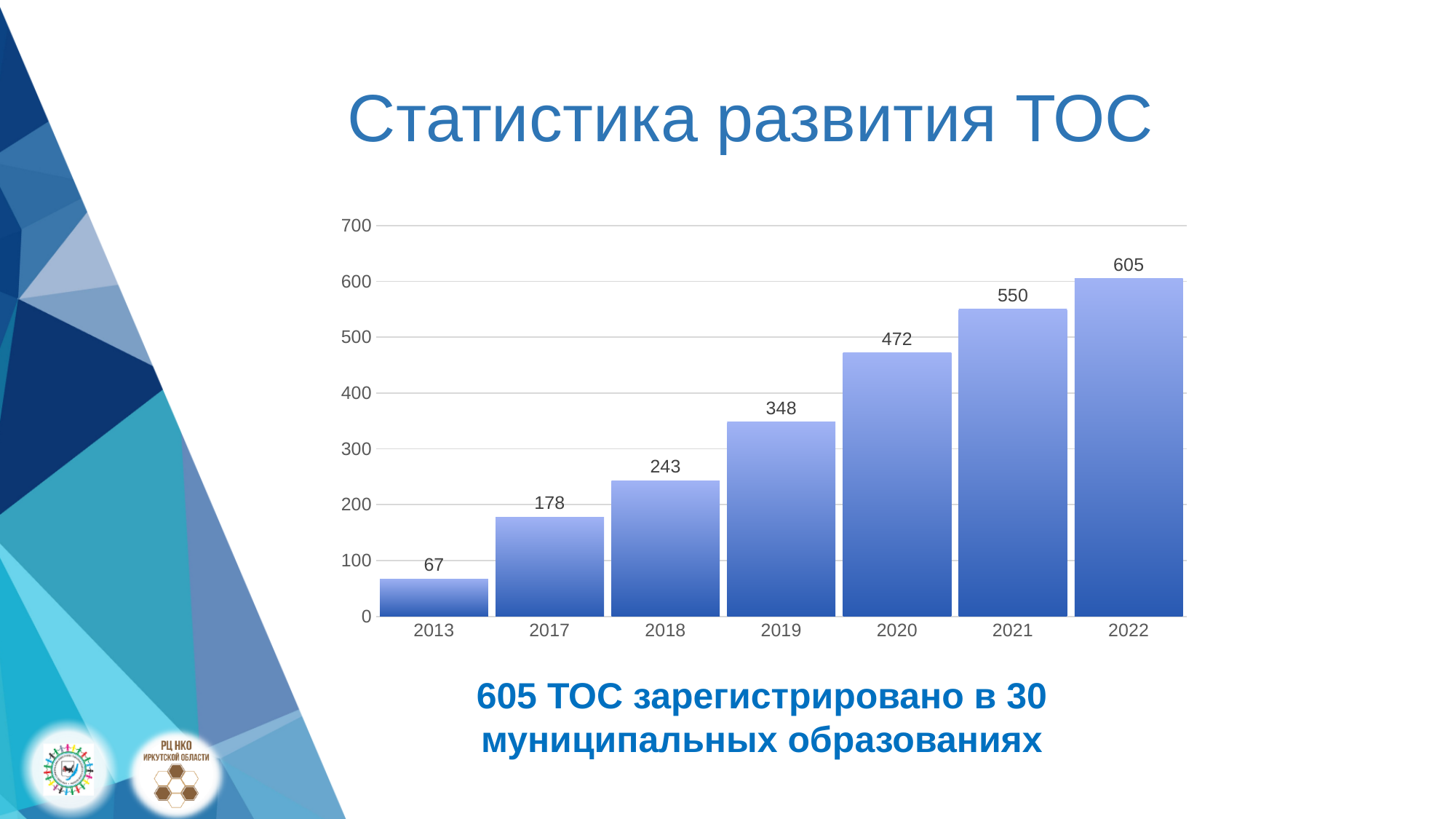
What kind of chart is shown on the slide? bar chart Which is larger, the value for 2020 or the value for 2019? 2020 What is the difference between the values for 2018 and 2017? 65 What is the value for 2021? 550 Which year has the lowest value? 2013 Is the value for 2020 greater or less than 400? greater What is the value for 2019? 348 What is the value for 2013? 67 Which year has the highest value? 2022 Do the values rise or fall from 2013 to 2022? rise How many years are shown on the x axis? 7 What is the difference between the values for 2022 and 2021? 55